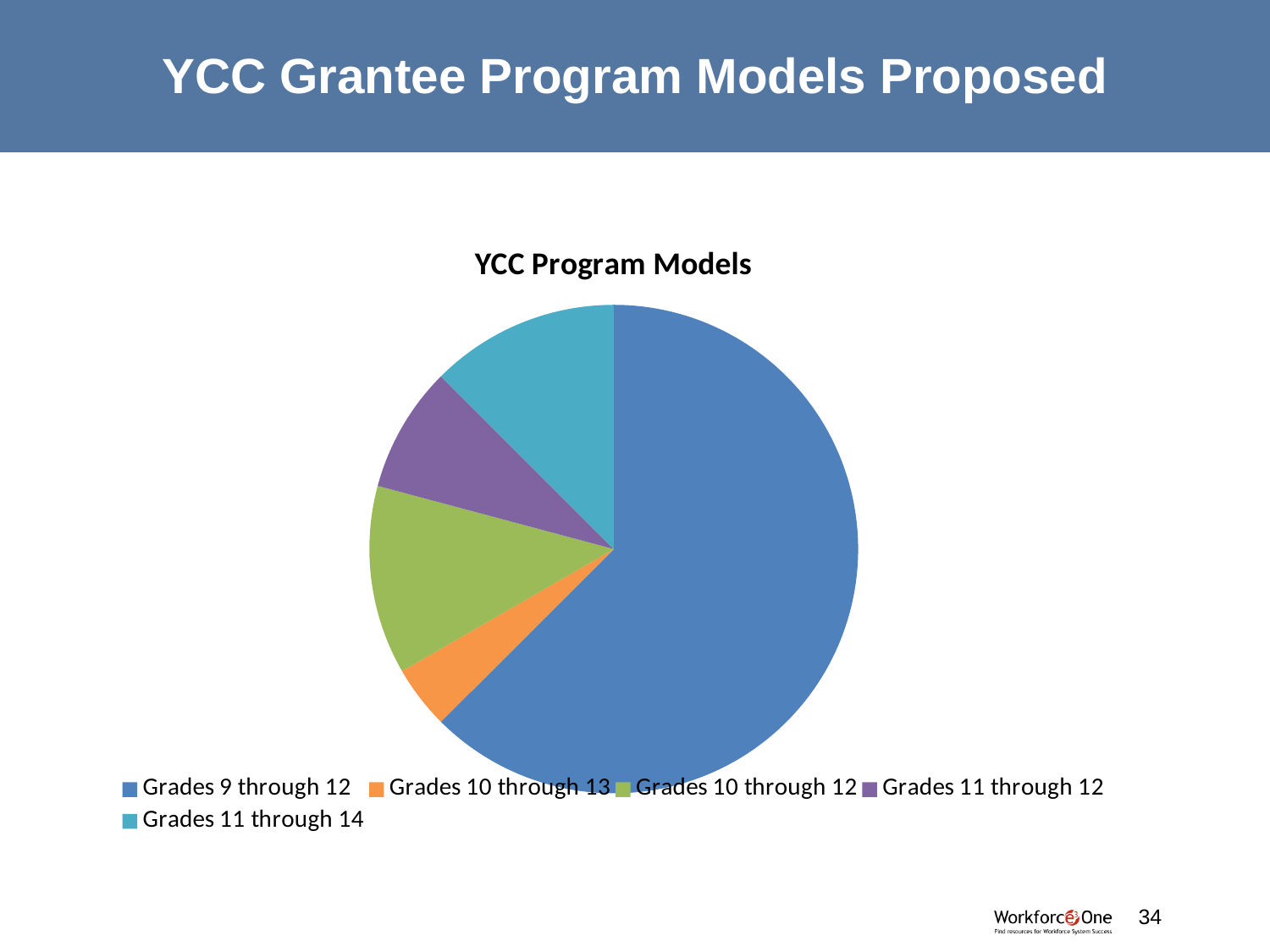
What colour is the slice for Grades 10 through 13? orange Does the largest slice, Grades 9 through 12, take up more or less than half of the pie? more What is the title of the chart? YCC Program Models Which slice is larger: Grades 11 through 12 or Grades 10 through 13? Grades 11 through 12 Which slice is larger: Grades 9 through 12 or Grades 11 through 14? Grades 9 through 12 Which program model has the largest slice of the pie? Grades 9 through 12 What kind of chart is shown on the slide? pie chart How many categories does the pie chart's legend list? 5 Which program model has the smallest slice of the pie? Grades 10 through 13